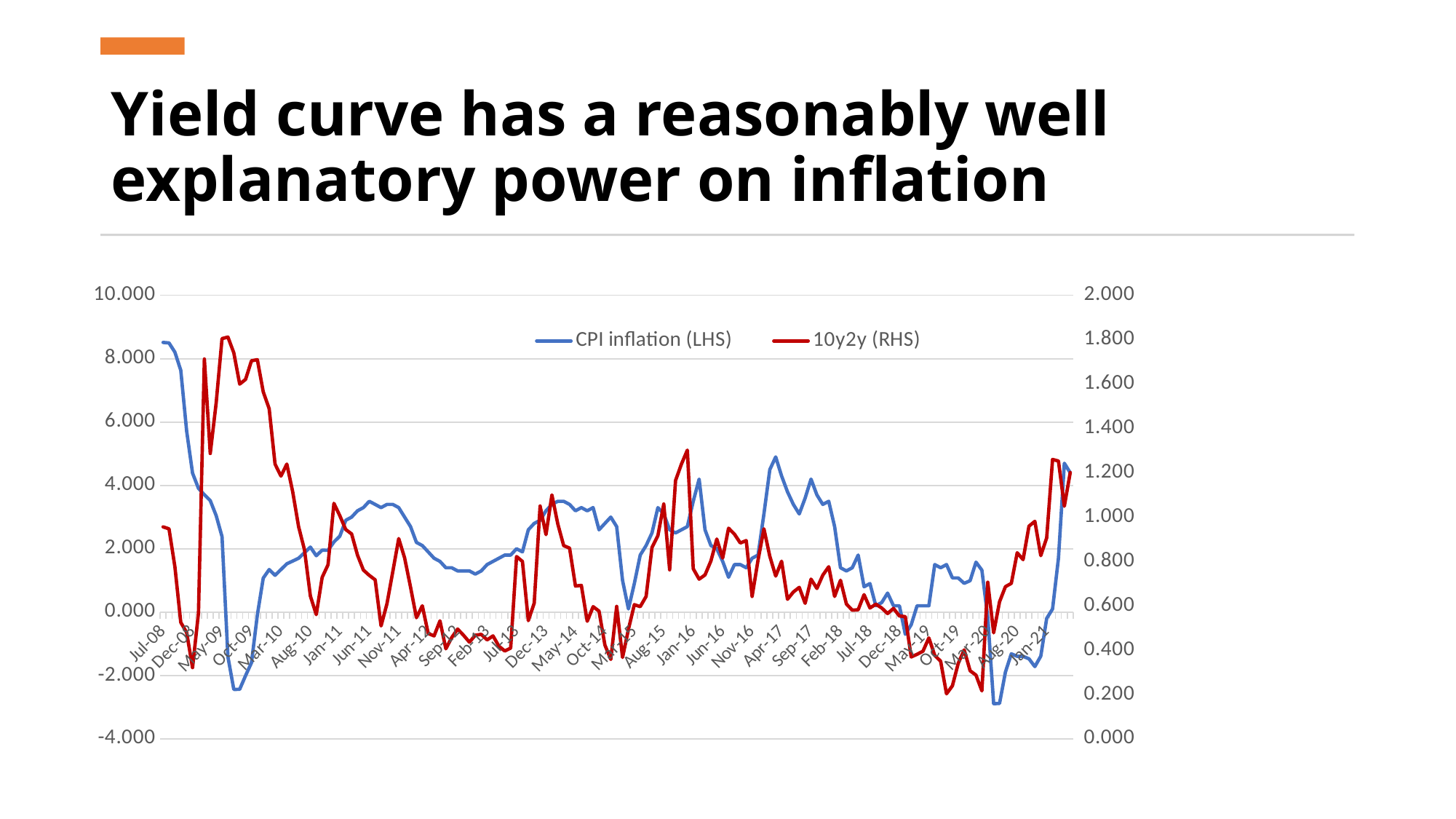
Is the value of CPI inflation (LHS) at Jul-08 greater or less than 8.000? greater Does 10y2y (RHS) rise or fall between Aug-20 and Jan-21? rise Does CPI inflation (LHS) rise or fall between Jul-08 and Dec-08? fall What kind of chart is shown on the slide? line chart Is the value of CPI inflation (LHS) around Apr-17 greater or less than 4.000? greater Is the value of 10y2y (RHS) around Oct-19 greater or less than 0.400? less How many series does the chart legend list? 2 Which series is plotted on the right-hand axis (RHS)? 10y2y (RHS) What colour is the CPI inflation (LHS) line? blue